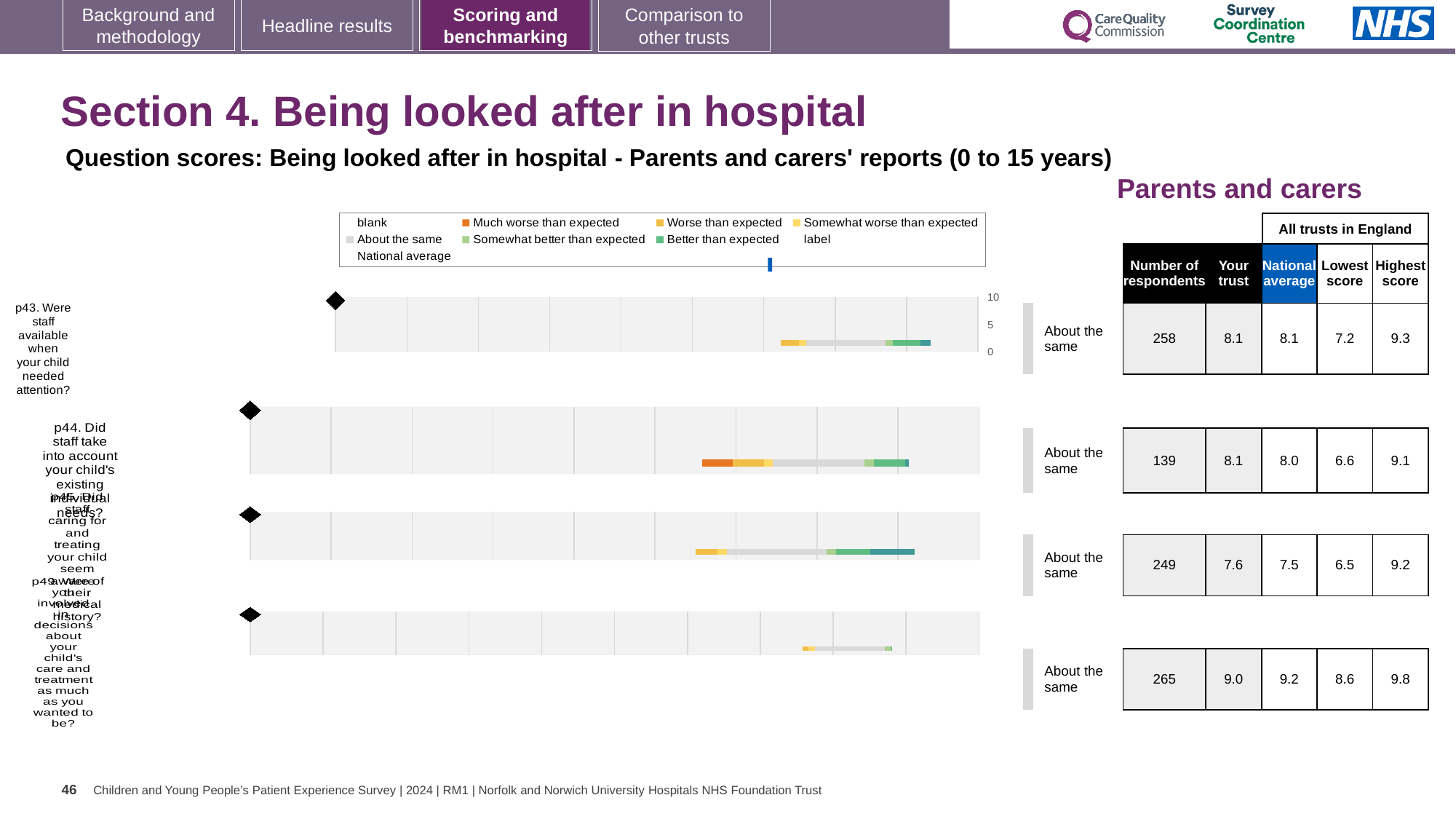
What is the highest score across all trusts in England for question p49? 9.8 What is the 'Your trust' score shown for question p45? 7.6 For question p49, which is larger: the 'Your trust' score or the national average? National average What is the title of the chart on this slide? Question scores: Being looked after in hospital - Parents and carers' reports (0 to 15 years) For question p44, what is the difference between the highest score and the lowest score across all trusts in England? 2.5 What benchmark category is shown next to the bar for question p43? About the same How many survey questions (rows) are plotted in the chart? 4 What is the number of respondents shown for question p43? 258 For question p45, how much higher is the 'Your trust' score than the national average? 0.1 What kind of chart is used to show the question scores on this slide? bar chart Which question has the highest 'Your trust' score? p49 Which question has the lowest number of respondents? p44